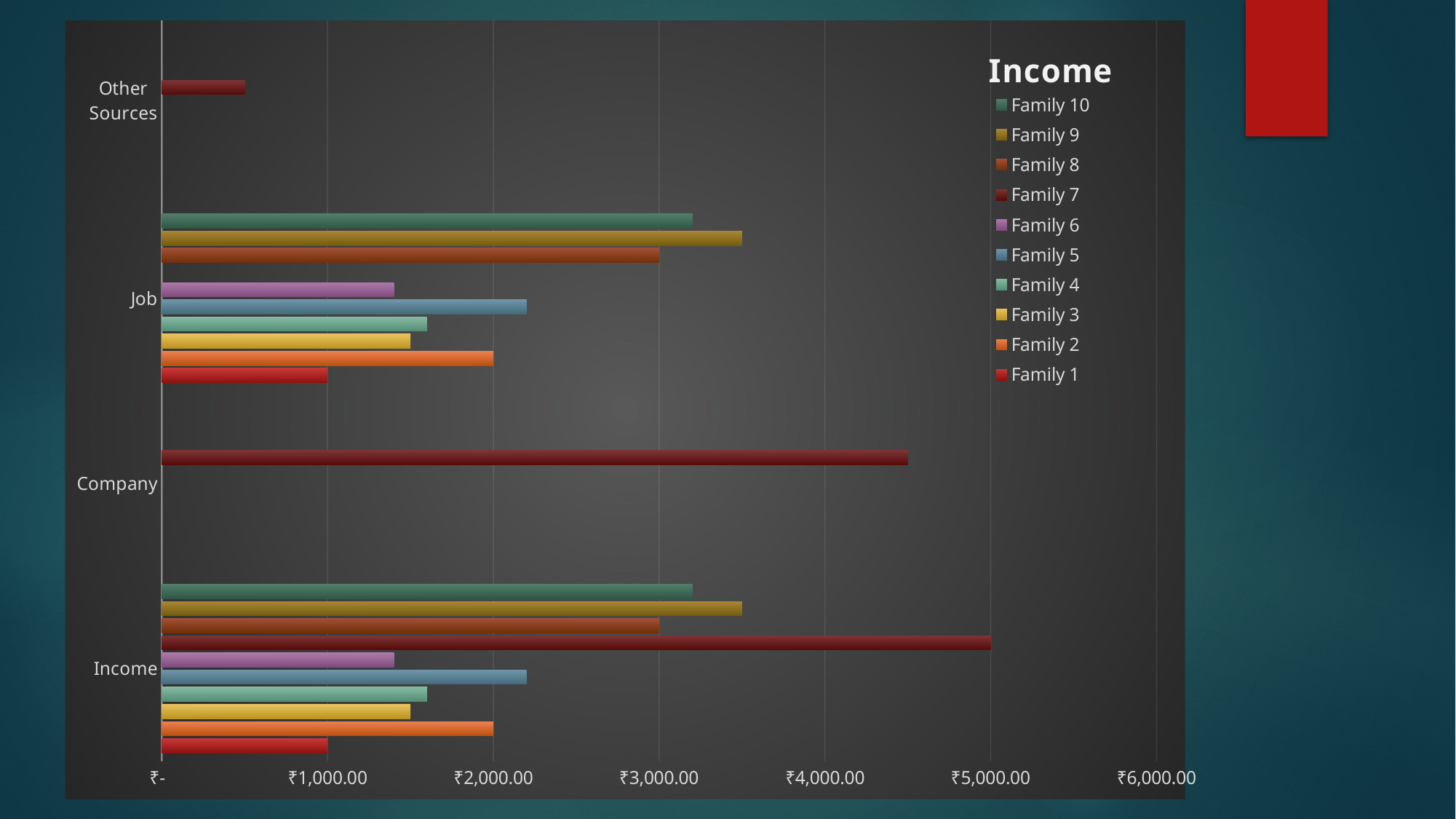
What kind of chart is shown on the slide? bar chart How many categories are shown on the vertical axis? 4 What is the value for Family 7 in the Income category? ₹5,000.00 In the Job category, which is larger: Family 5 or Family 6? Family 5 In the Job category, which is larger: Family 9 or Family 10? Family 9 What is the title of the chart? Income Is the value for Family 7 in the Company category greater or less than ₹4,000.00? greater In the Income category, which family has the highest value? Family 7 How many series does the legend list? 10 What is the value for Family 8 in the Income category? ₹3,000.00 Is the value for Family 7 in the Other Sources category greater or less than ₹1,000.00? less In the Income category, which family has the lowest value? Family 1